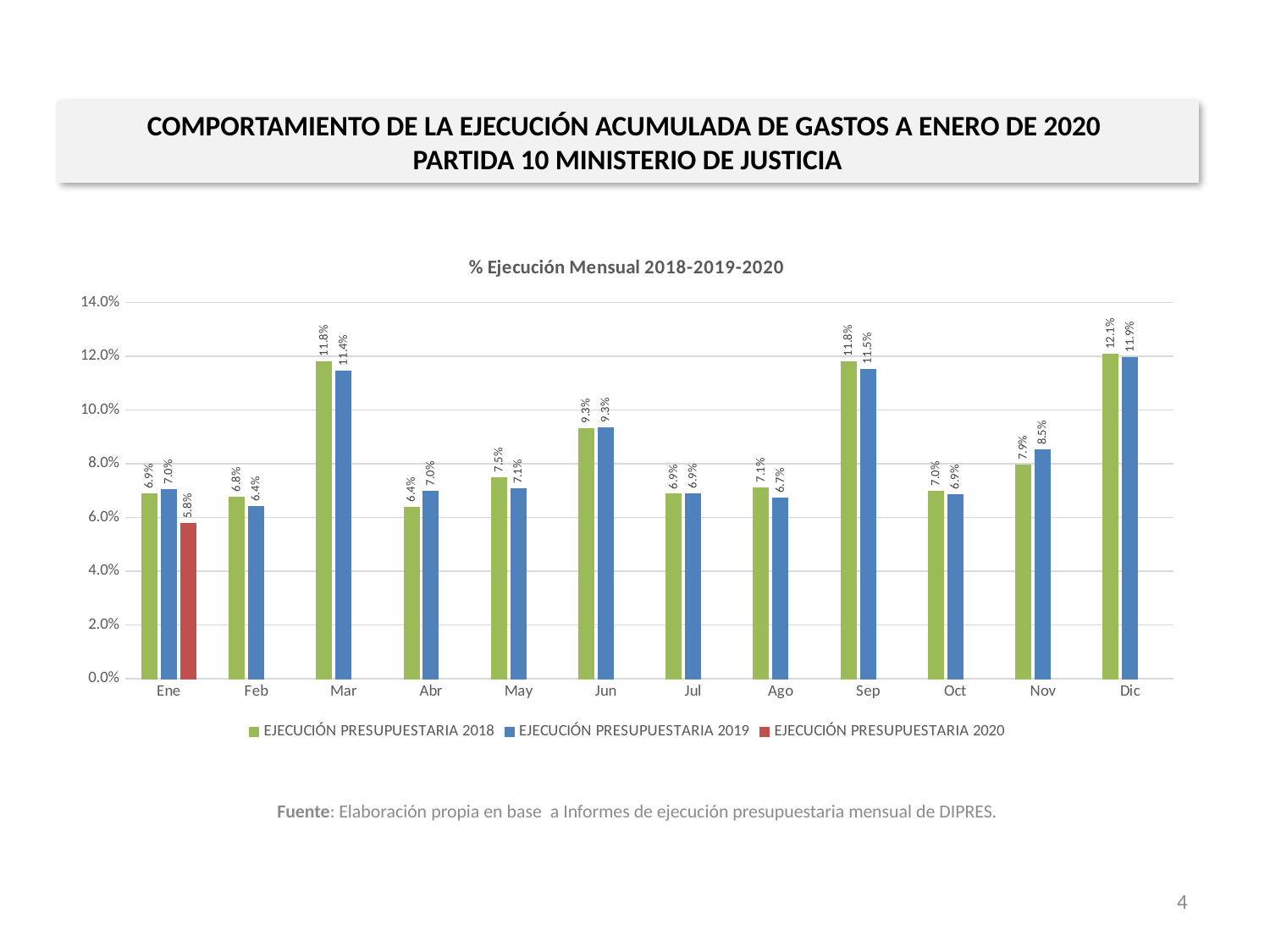
What is the title of the chart? % Ejecución Mensual 2018-2019-2020 Which month has the highest value for EJECUCIÓN PRESUPUESTARIA 2018? Dic What kind of chart is shown on the slide? Bar chart In Abr, which is larger: the 2018 value or the 2019 value? EJECUCIÓN PRESUPUESTARIA 2019 What is the value for EJECUCIÓN PRESUPUESTARIA 2019 in Nov? 8.5% How many series does the legend list? 3 Which month has the lowest value for EJECUCIÓN PRESUPUESTARIA 2019? Feb How many months are shown on the x axis? 12 Is the value for EJECUCIÓN PRESUPUESTARIA 2019 in Sep greater or less than 10.0%? greater What is the difference between the 2018 and 2019 values in Nov? 0.6 percentage points What is the value for EJECUCIÓN PRESUPUESTARIA 2018 in Mar? 11.8% What is the value for EJECUCIÓN PRESUPUESTARIA 2020 in Ene? 5.8%